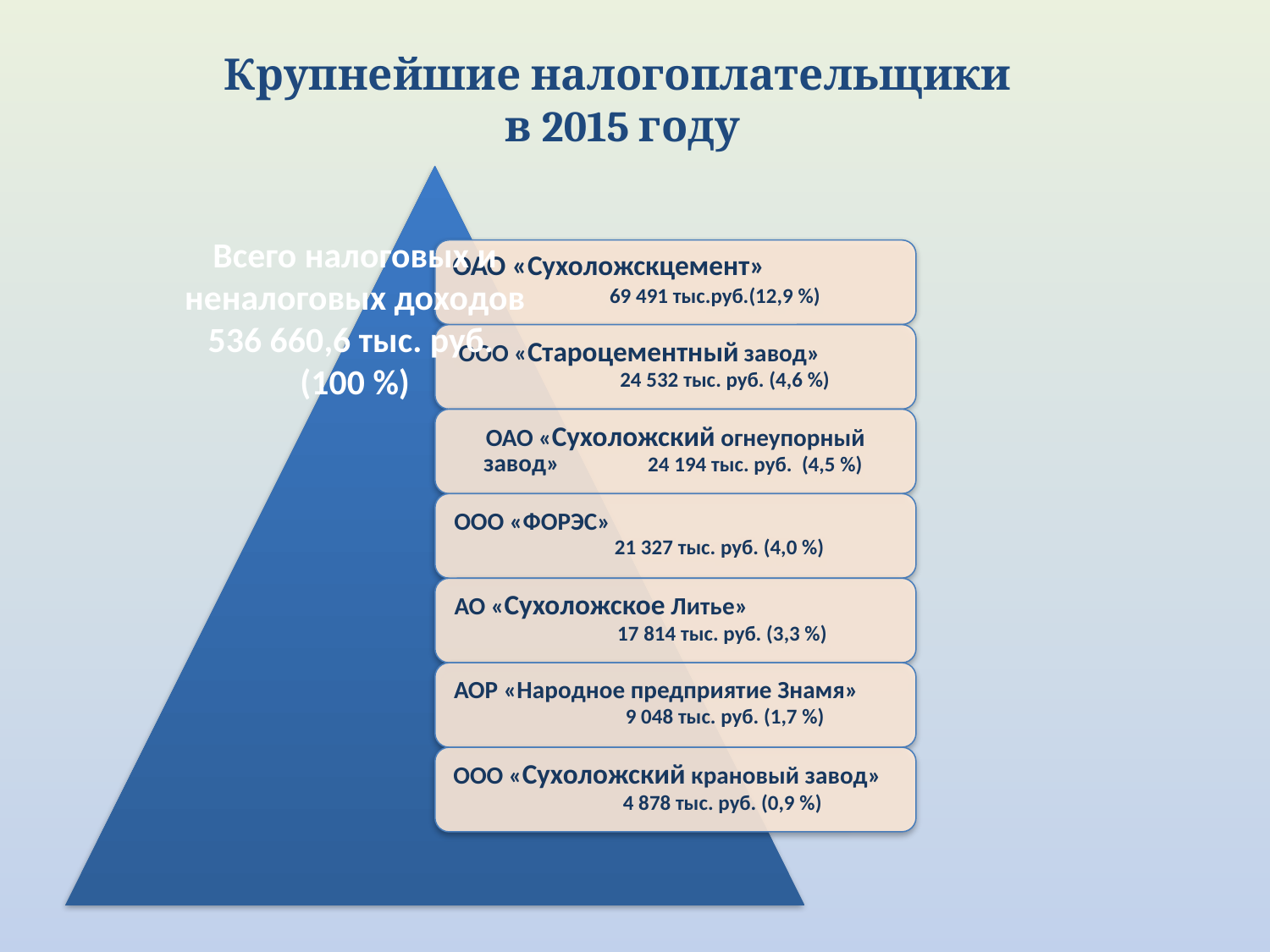
What amount is shown for ОАО «Сухоложскцемент»? 69 491 тыс.руб. Which has the larger amount: ООО «Староцементный завод» or ОАО «Сухоложский огнеупорный завод»? ООО «Староцементный завод» Which taxpayer has the smallest amount? ООО «Сухоложский крановый завод» What percentage share is shown for АО «Сухоложское Литье»? 3,3 % What amount is shown for АОР «Народное предприятие Знамя»? 9 048 тыс. руб. What is the total of all tax and non-tax revenues shown on the slide? 536 660,6 тыс. руб. Which taxpayer has the largest amount? ОАО «Сухоложскцемент» What share of total revenues does ОАО «Сухоложскцемент» account for? 12,9 % What is the difference in тыс. руб. between ОАО «Сухоложскцемент» and ООО «Староцементный завод»? 44 959 What is the title of the slide? Крупнейшие налогоплательщики в 2015 году What percentage share is shown for ООО «ФОРЭС»? 4,0 % How many taxpayers are listed in the pyramid? 7